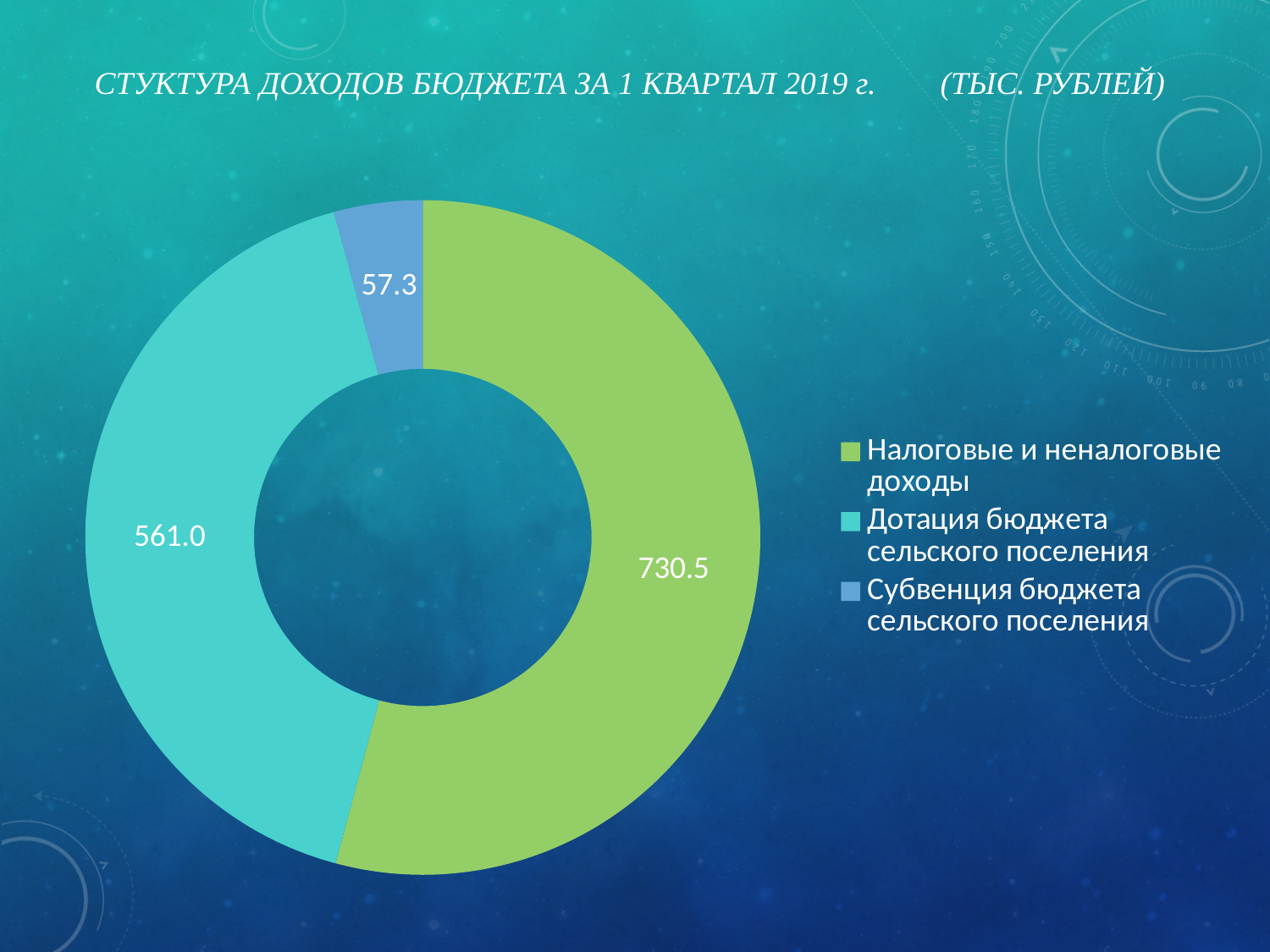
Which category has the largest value? Налоговые и неналоговые доходы What is the value for Налоговые и неналоговые доходы? 730.5 Which category has the smallest value? Субвенция бюджета сельского поселения What is the value for Дотация бюджета сельского поселения? 561.0 Which is larger: Дотация бюджета сельского поселения or Субвенция бюджета сельского поселения? Дотация бюджета сельского поселения What type of chart is shown on the slide? Doughnut (pie) chart What is the total of all three slices? 1348.8 What is the value for Субвенция бюджета сельского поселения? 57.3 How many categories does the chart show? 3 What is the difference between the values for Дотация бюджета сельского поселения and Субвенция бюджета сельского поселения? 503.7 What is the difference between the values for Налоговые и неналоговые доходы and Дотация бюджета сельского поселения? 169.5 What unit is stated in the chart title? тыс. рублей